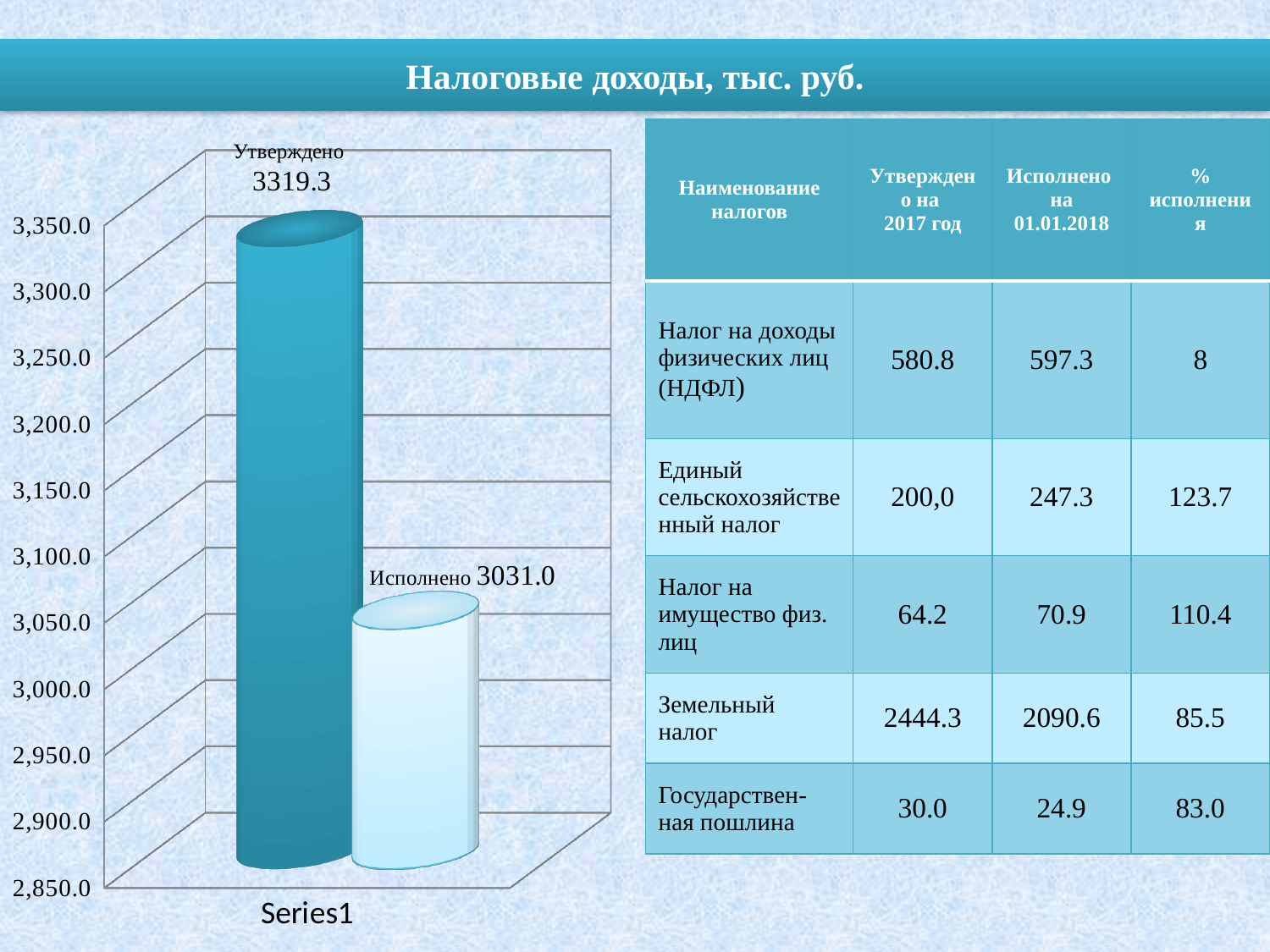
Is the value for Исполнено greater or less than 3,050.0? less What is the value of the Исполнено bar? 3031.0 What kind of chart is shown on the slide? bar chart Which bar is taller, Утверждено or Исполнено? Утверждено Is the value for Утверждено greater or less than 3,300.0? greater How many bars are plotted in the chart? 2 Which bar has the lowest value? Исполнено What is the title of the slide above the chart? Налоговые доходы, тыс. руб. Which bar has the highest value? Утверждено What label appears on the horizontal axis below the bars? Series1 What is the difference between the Утверждено and Исполнено values? 288.3 What is the value of the Утверждено bar? 3319.3